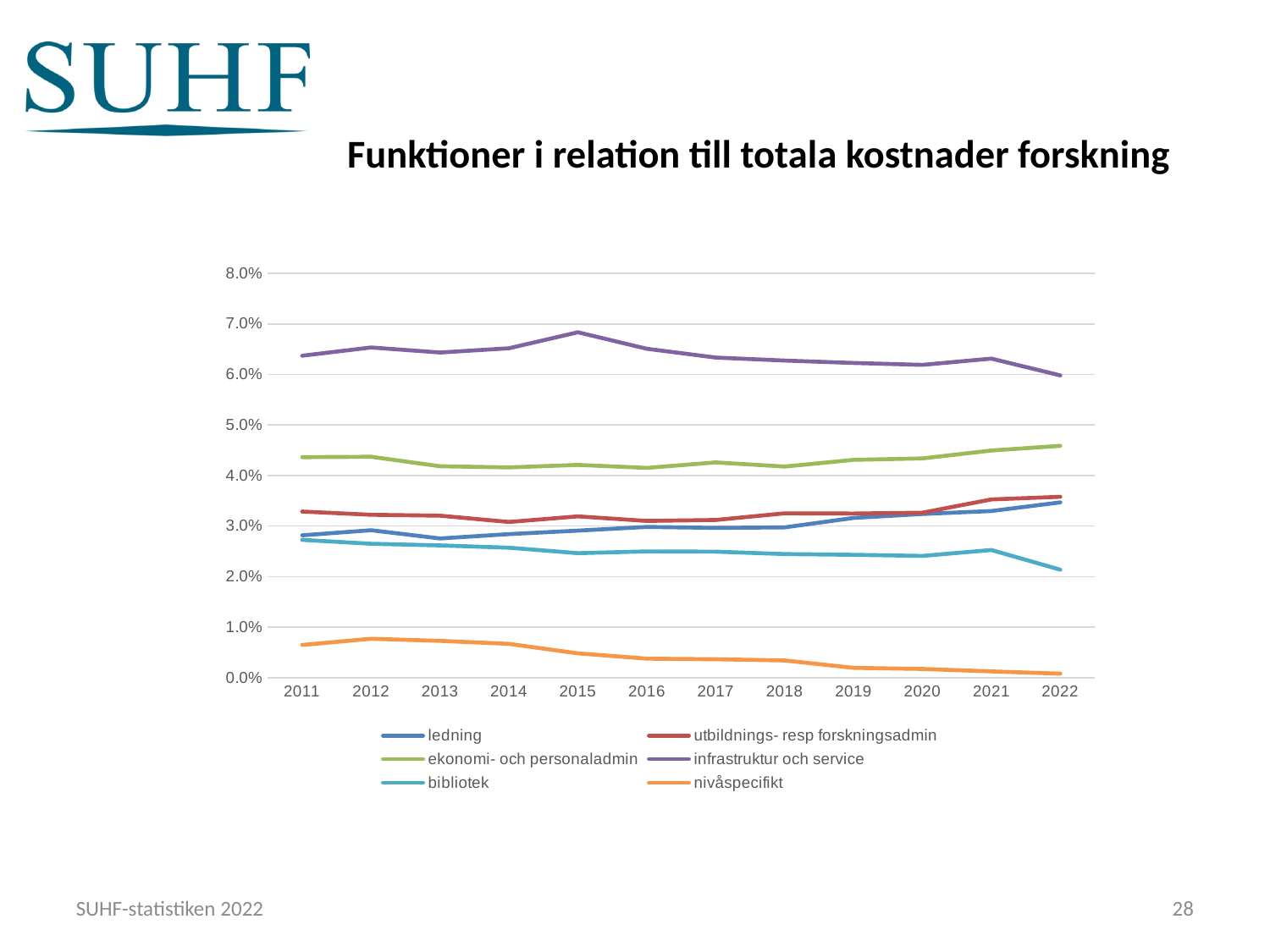
Does the bibliotek line rise or fall from 2011 to 2022? fall Is the value for nivåspecifikt in 2022 greater or less than 1.0%? less Which series has the highest values across the whole chart? infrastruktur och service In 2022, which is larger: ledning or bibliotek? ledning How many series does the legend list? 6 What kind of chart is shown on the slide? line chart Which series has the lowest values across the whole chart? nivåspecifikt How many years are shown on the x axis? 12 Is the value for bibliotek in 2022 greater or less than 3.0%? less What is the title of the chart? Funktioner i relation till totala kostnader forskning Is the value for infrastruktur och service in 2015 greater or less than 6.0%? greater